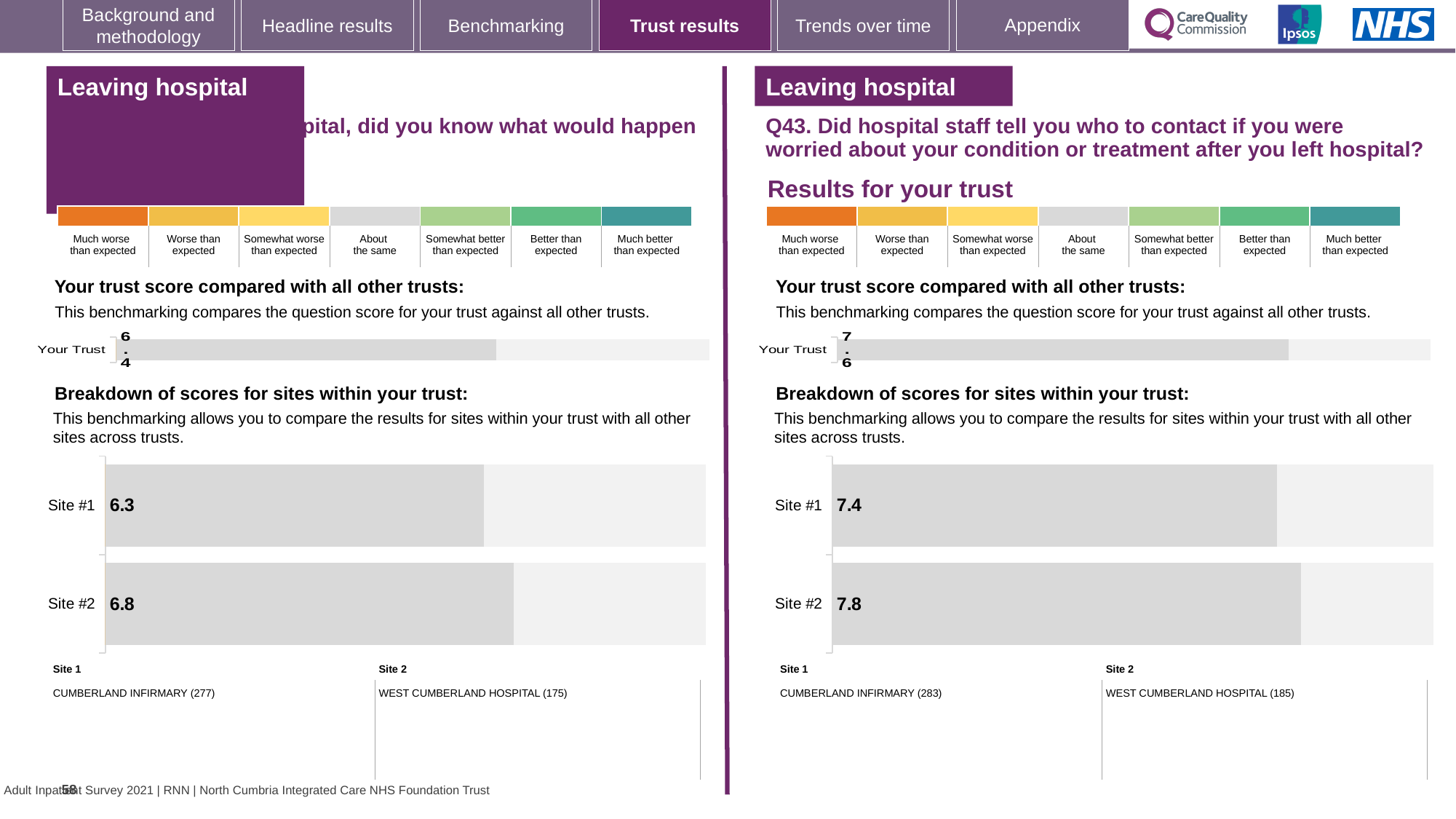
On the left-hand side of the slide, what is the score shown for Your Trust in the trust score chart? 6.4 In the left-hand site breakdown chart, what is the score for Site #2? 6.8 On the right-hand side of the slide (Q43), what is the score shown for Your Trust in the trust score chart? 7.6 In the right-hand (Q43) site breakdown chart, which site has the lower score? Site #1 In the right-hand (Q43) site breakdown chart, what is the score for Site #1? 7.4 What type of chart is used for the site breakdown on the left-hand side of the slide? Bar chart In the left-hand site breakdown chart, which site has the higher score? Site #2 In the right-hand (Q43) site breakdown chart, what is the difference between the Site #2 and Site #1 scores? 0.4 In the left-hand site breakdown chart, what is the score for Site #1? 6.3 In the left-hand site breakdown chart, what is the difference between the Site #2 and Site #1 scores? 0.5 How many sites are shown in the right-hand (Q43) site breakdown chart? 2 In the right-hand (Q43) site breakdown chart, what is the score for Site #2? 7.8